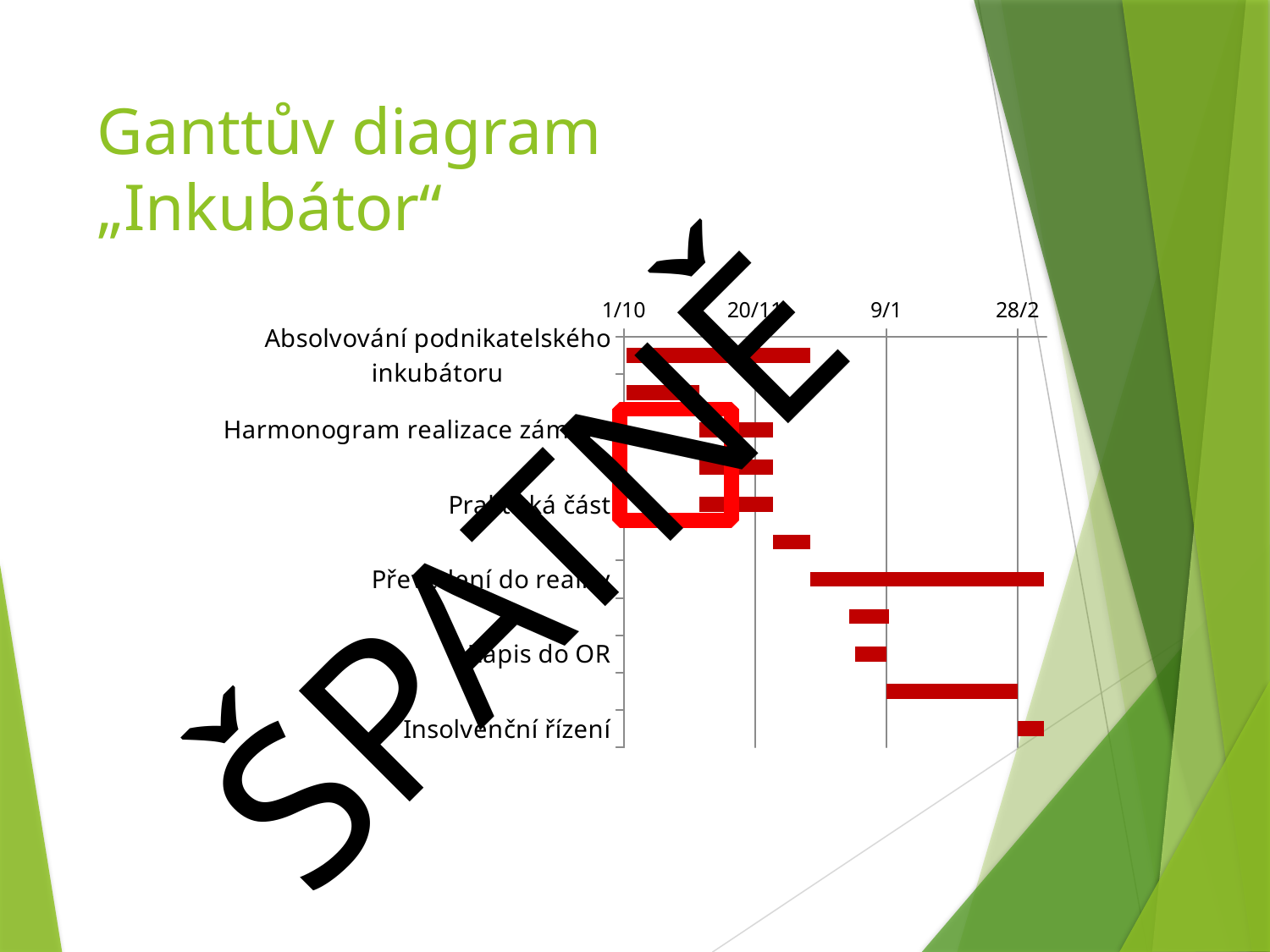
Which task's bar starts earliest on the chart? Absolvování podnikatelského inkubátoru Does the bar for Insolvenční řízení lie before or after the 9/1 tick? after What is the last date label on the horizontal axis? 28/2 What is the first date label on the horizontal axis? 1/10 How many date labels are shown on the horizontal axis of the chart? 4 What kind of chart is shown on the slide? Bar chart (Gantt chart) What colour are the bars in the chart? Red How many task labels are listed on the vertical axis of the chart? 6 Does the bar for Absolvování podnikatelského inkubátoru start before or after the 9/1 tick? before What is the title of the slide containing the Gantt chart? Ganttův diagram „Inkubátor“